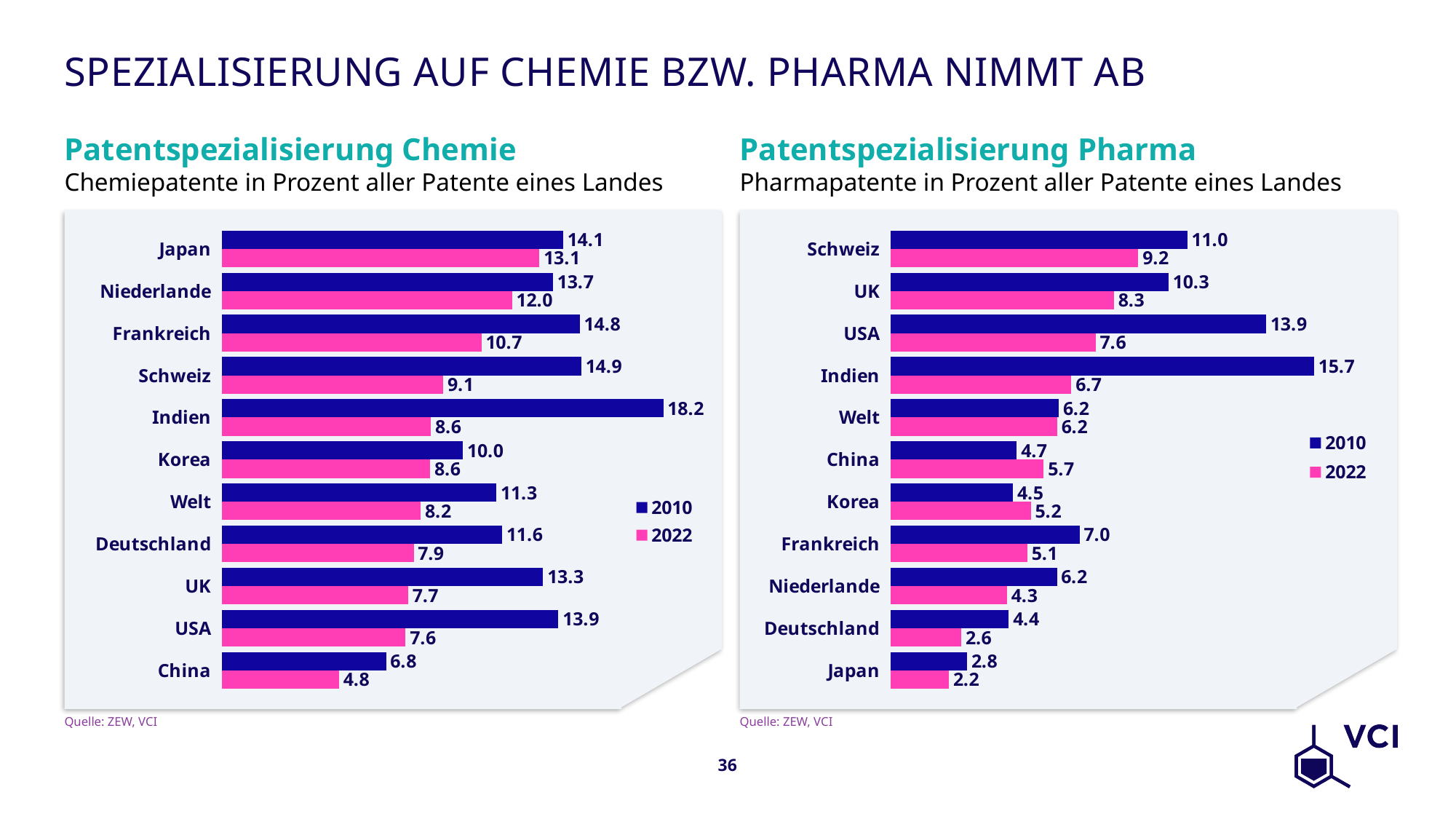
In the 'Patentspezialisierung Pharma' chart, how many series does the legend list? 2 In the 'Patentspezialisierung Chemie' chart, how many categories are shown? 11 In the 'Patentspezialisierung Chemie' chart, what is the 2022 value for Deutschland? 7.9 In the 'Patentspezialisierung Chemie' chart, which category has the lowest 2022 value? China In the 'Patentspezialisierung Pharma' chart, what is the 2022 value for Schweiz? 9.2 In the 'Patentspezialisierung Pharma' chart, which is larger for China: the 2010 value or the 2022 value? 2022 In the 'Patentspezialisierung Pharma' chart, which colour represents the 2022 series? Pink In the 'Patentspezialisierung Pharma' chart, which country has the highest 2010 value? Indien In the 'Patentspezialisierung Chemie' chart, what is the 2010 value for Indien? 18.2 In the 'Patentspezialisierung Pharma' chart, what is the difference between the 2010 and 2022 values for USA? 6.3 In the 'Patentspezialisierung Chemie' chart, what is the difference between the 2010 and 2022 values for Schweiz? 5.8 What type of chart is the 'Patentspezialisierung Chemie' chart? Bar chart